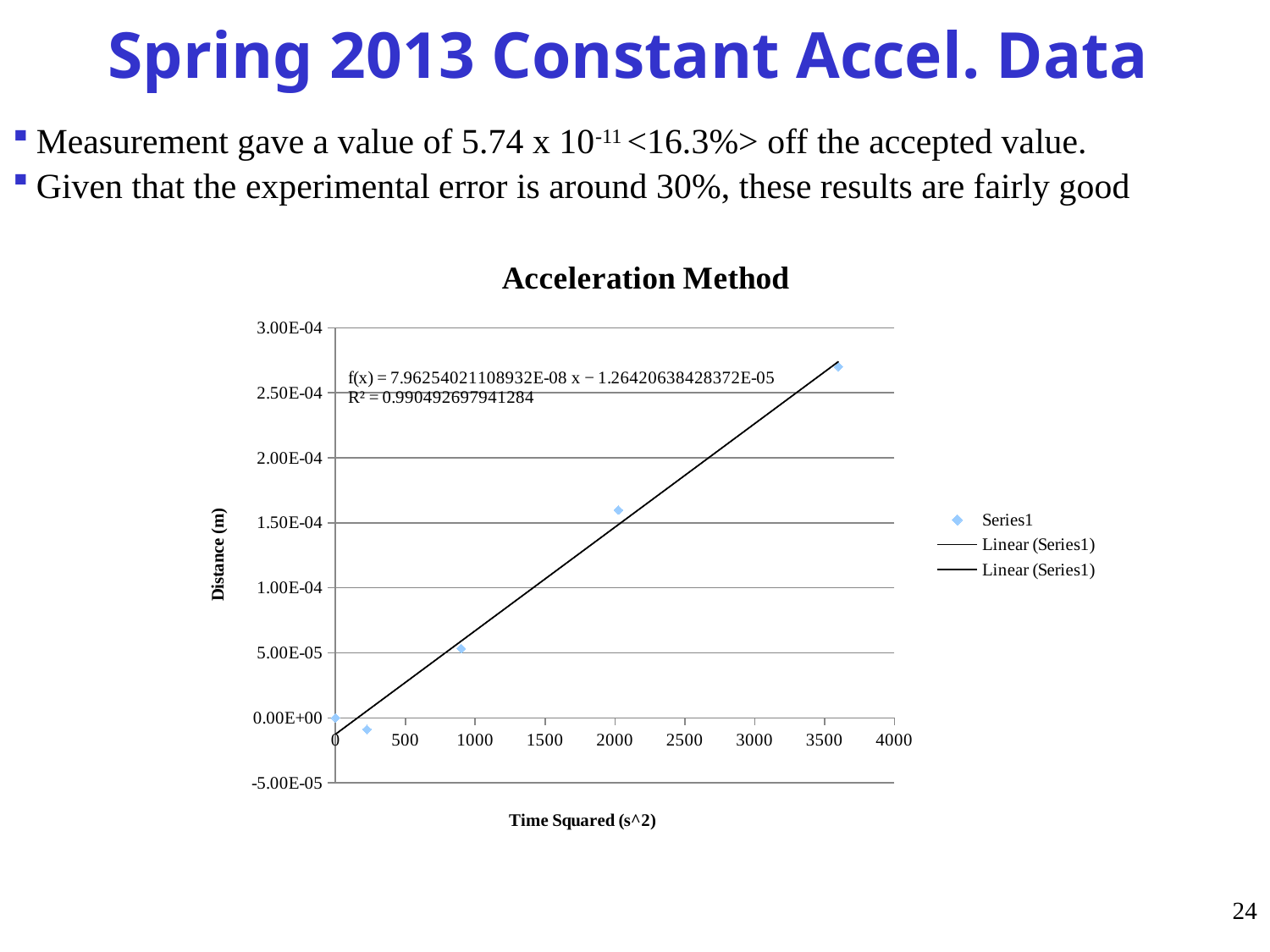
Do the Series1 values rise or fall as Time Squared increases along the x axis? rise How many entries does the chart legend list? 3 What is the label of the x axis? Time Squared (s^2) What kind of chart is shown on the slide? scatter chart What R² value is printed on the chart for the linear fit? 0.990492697941284 Is the Distance value for the data point near 900 s^2 greater or less than 1.00E-04? less Is the Distance value for the data point near 250 s^2 greater or less than 0.00E+00? less Which data point has the highest Distance value: the one near 900 s^2 or the one near 3600 s^2? the one near 3600 s^2 What is the title of the chart? Acceleration Method Is the Distance value for the data point near 3600 s^2 greater or less than 2.50E-04? greater How many data points are plotted for Series1? 5